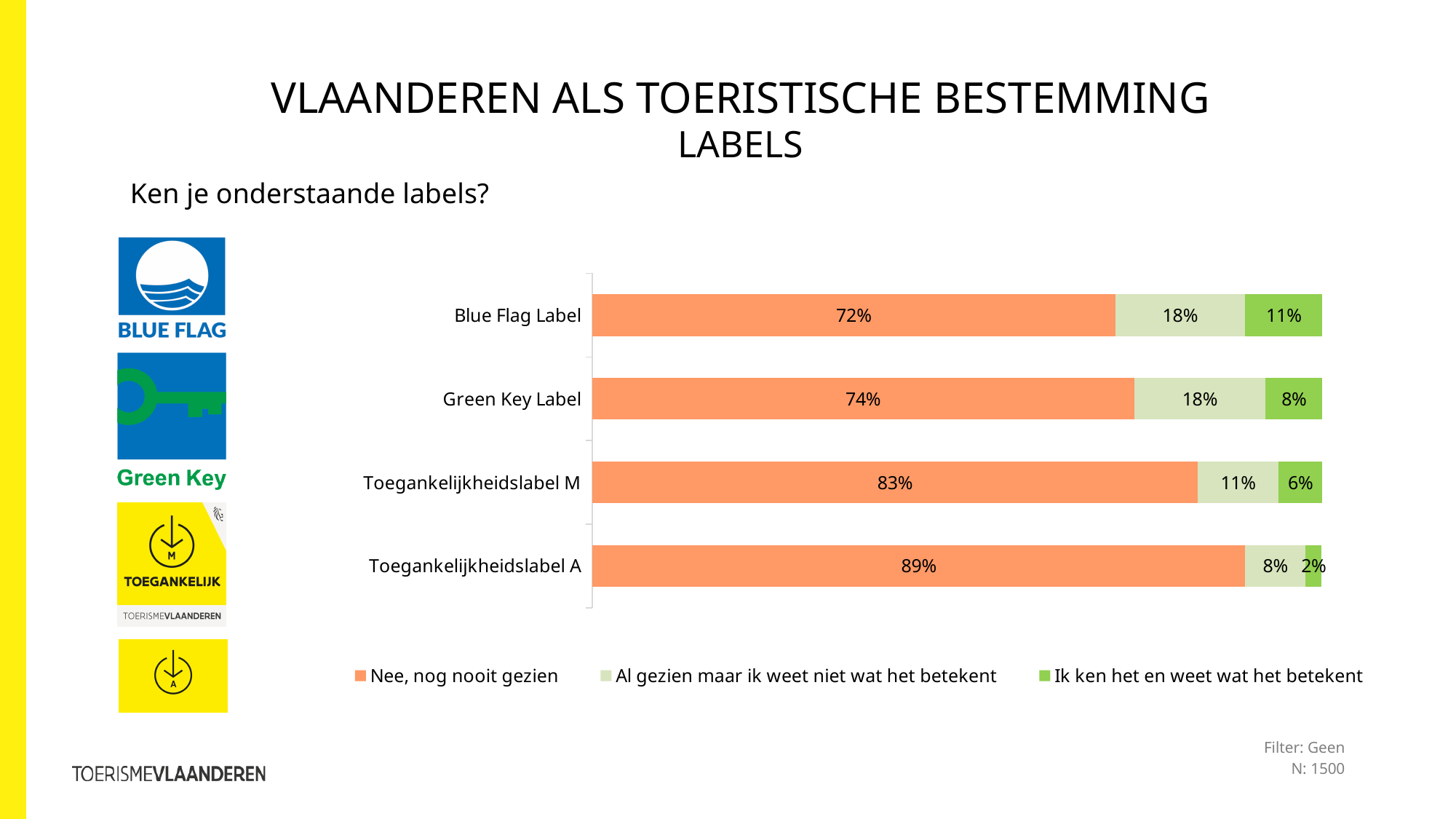
Which label has the highest share of "Nee, nog nooit gezien" responses? Toegankelijkheidslabel A What percentage of respondents answered "Nee, nog nooit gezien" for the Blue Flag Label? 72% What percentage of respondents answered "Al gezien maar ik weet niet wat het betekent" for Toegankelijkheidslabel M? 11% What is the difference between the "Nee, nog nooit gezien" percentages for Toegankelijkheidslabel A and Blue Flag Label? 17% What kind of chart is shown on the slide? Stacked bar chart What percentage of respondents answered "Ik ken het en weet wat het betekent" for the Green Key Label? 8% Which label has the highest share of "Ik ken het en weet wat het betekent" responses? Blue Flag Label How many labels are shown in the chart? 4 Which is larger: the "Nee, nog nooit gezien" share for Green Key Label or for Blue Flag Label? Green Key Label What percentage of respondents answered "Nee, nog nooit gezien" for Toegankelijkheidslabel A? 89% How many series does the legend list? 3 Which label has the lowest share of "Ik ken het en weet wat het betekent" responses? Toegankelijkheidslabel A